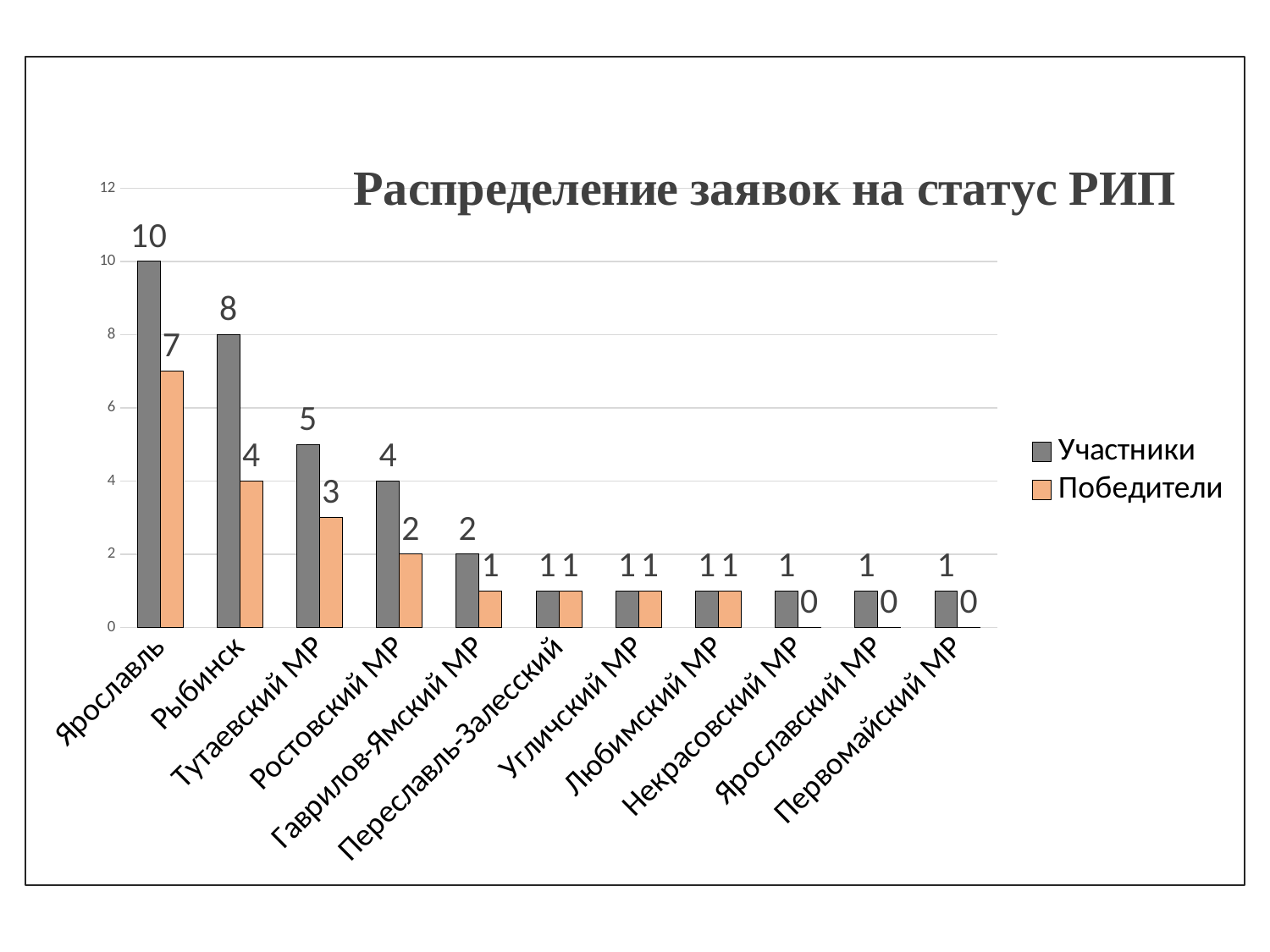
What kind of chart is shown? Bar chart Which is larger: Победители in Ярославль or Участники in Тутаевский МР? Победители in Ярославль What is the difference between Участники in Рыбинск and Участники in Тутаевский МР? 3 How many categories are shown on the x axis? 11 What is the value for Победители in Тутаевский МР? 3 What is the value for Участники in Ростовский МР? 4 What is the value for Участники in Ярославль? 10 How many series does the legend list? 2 What is the value for Победители in Рыбинск? 4 What is the difference between Участники and Победители in Ярославль? 3 Which category has the highest value for Участники? Ярославль What is the title of the chart? Распределение заявок на статус РИП